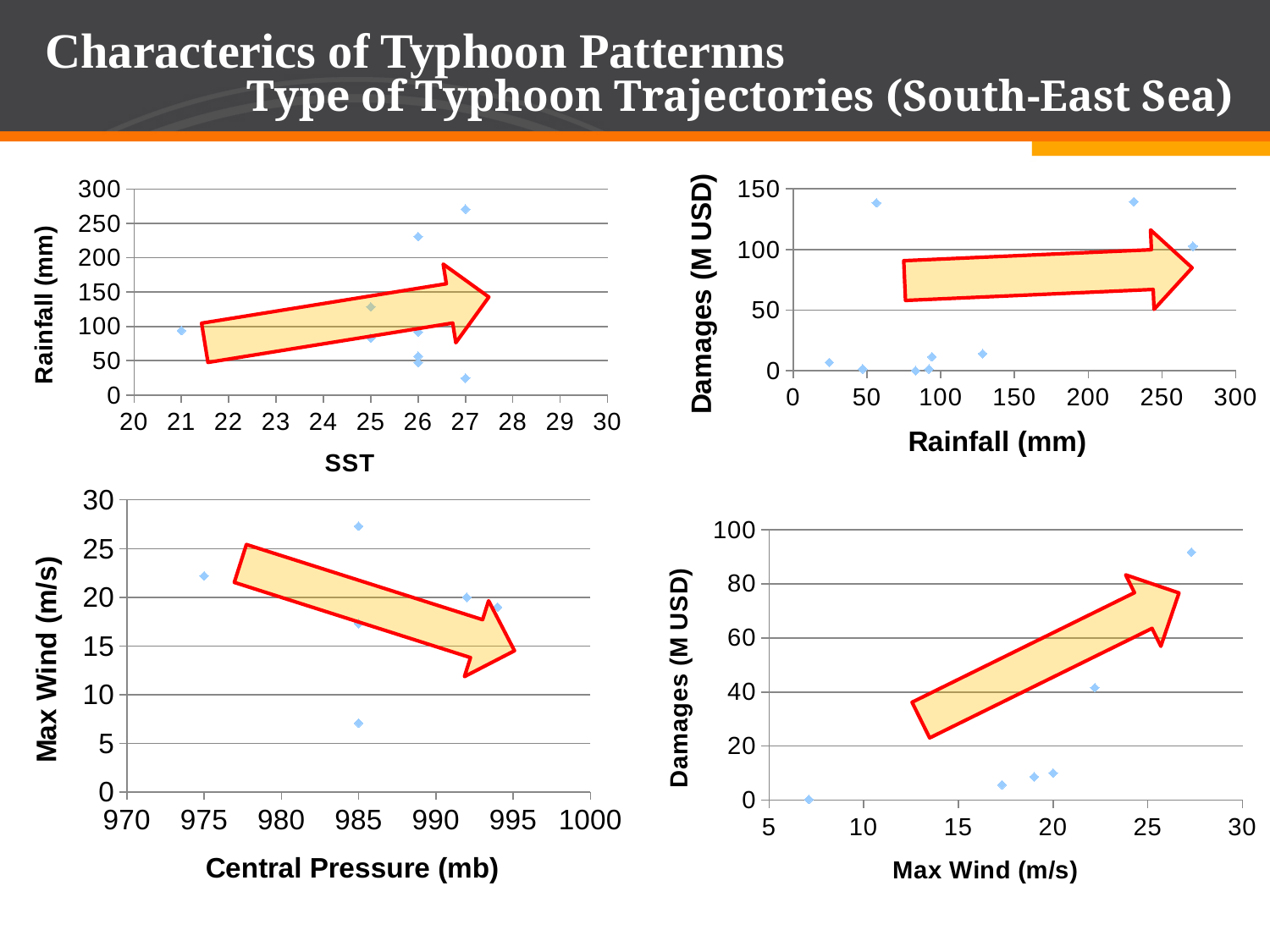
In the top-right chart (Damages vs Rainfall), do damages generally rise or fall as rainfall increases? rise In the top-left chart (Rainfall vs SST), do the values generally rise or fall as SST increases? rise In the bottom-right chart (Damages vs Max Wind), do damages generally rise or fall as max wind increases? rise In the bottom-left chart, is the lowest max wind value plotted greater or less than 10? less What is the y-axis label of the top-right chart? Damages (M USD) In the top-right chart, is the damages value for the point at about 270 mm rainfall greater or less than 50? greater What is the x-axis label of the bottom-left chart? Central Pressure (mb) What kind of chart is the top-left chart with SST on the x axis? scatter chart How many data points are plotted in the bottom-right chart (Damages vs Max Wind)? 6 In the top-left chart, is the highest rainfall value plotted greater or less than 250? greater